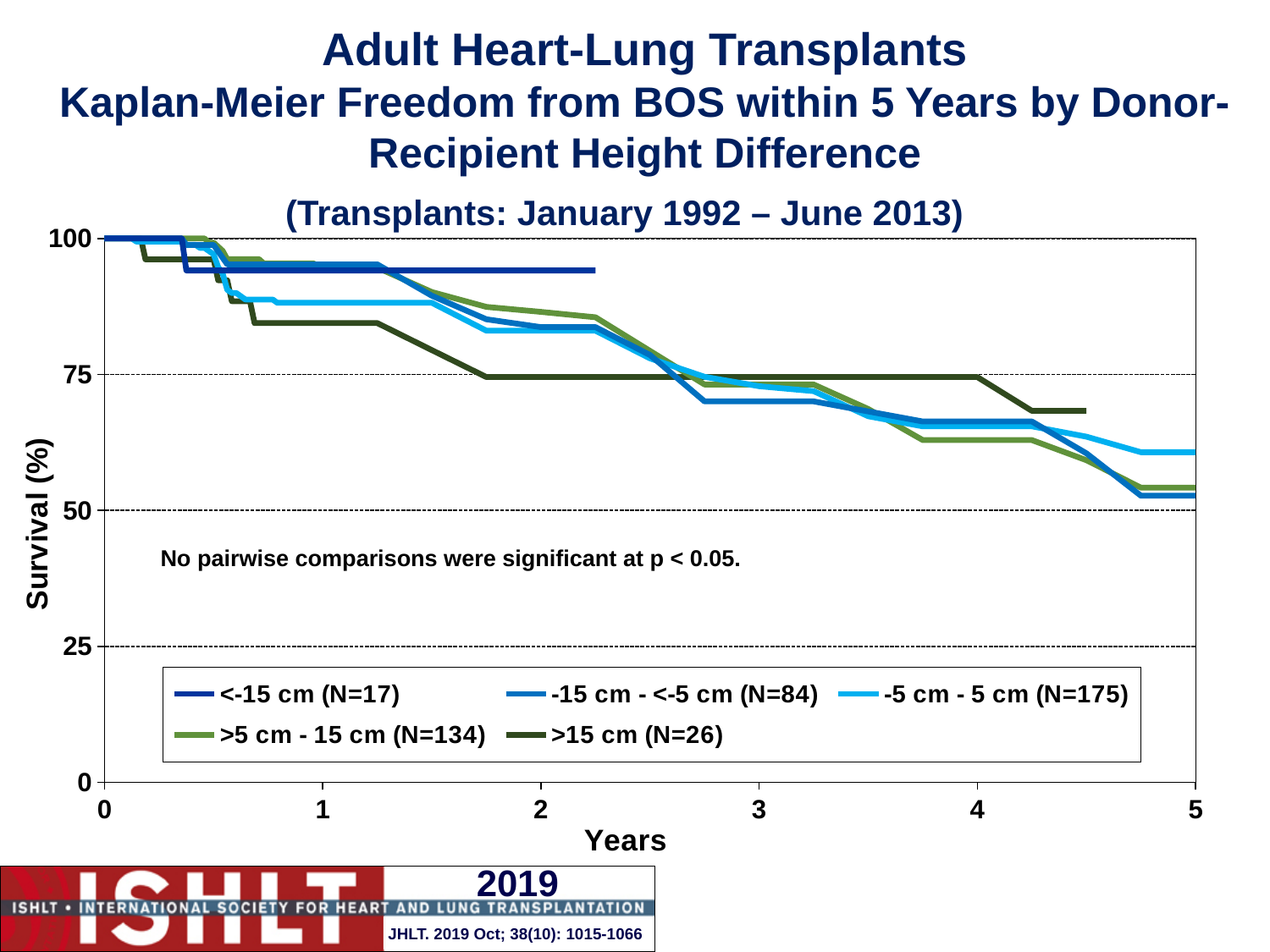
Does the survival for the -5 cm - 5 cm group rise or fall as years increase? Fall At year 4, which group has higher survival: >15 cm or >5 cm - 15 cm? >15 cm According to the legend, what is the N for the -5 cm - 5 cm group? N=175 Is the survival value for the >15 cm group at year 1 greater or less than 75? greater Is the survival value for the <-15 cm group at year 2 greater or less than 75? greater What is the label of the x axis? Years Is the survival value for the -15 cm - <-5 cm group at year 3 greater or less than 75? less How many series does the legend list? 5 At year 1, which group has higher survival: <-15 cm or >15 cm? <-15 cm What kind of chart is shown on the slide? Line chart Does the survival for the >5 cm - 15 cm group rise or fall from year 0 to year 5? Fall